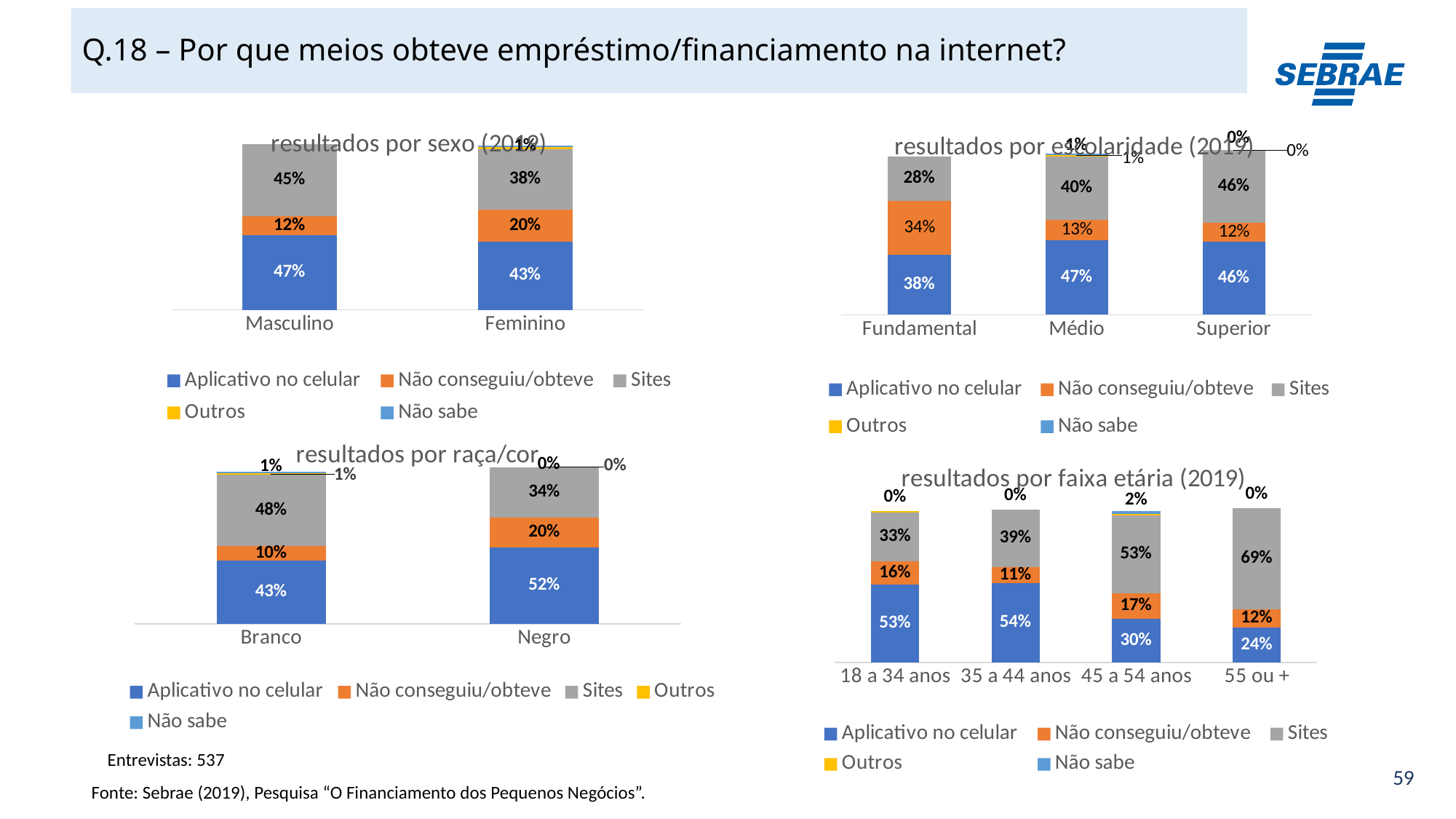
In the 'resultados por faixa etária (2019)' chart, how many series does the legend list? 5 In the 'resultados por sexo (2019)' chart, what is the difference between the 'Sites' values for Masculino and Feminino? 7% In the 'resultados por raça/cor' chart, which is larger: the 'Sites' value for Branco or for Negro? Branco What type of chart is 'resultados por faixa etária (2019)'? Stacked bar chart In the 'resultados por escolaridade (2019)' chart, which education level has the highest 'Sites' value? Superior In the 'resultados por faixa etária (2019)' chart, which age group has the lowest 'Aplicativo no celular' value? 55 ou + In the 'resultados por faixa etária (2019)' chart, what is the 'Sites' value for '55 ou +'? 69% In the 'resultados por sexo (2019)' chart, what is the value of 'Aplicativo no celular' for Masculino? 47% In the 'resultados por escolaridade (2019)' chart, what is the value of 'Não conseguiu/obteve' for Fundamental? 34% In the 'resultados por raça/cor' chart, what is the value of 'Aplicativo no celular' for Negro? 52% In the 'resultados por sexo (2019)' chart, what is the value of 'Não conseguiu/obteve' for Feminino? 20% In the 'resultados por escolaridade (2019)' chart, how many categories are shown on the x axis? 3